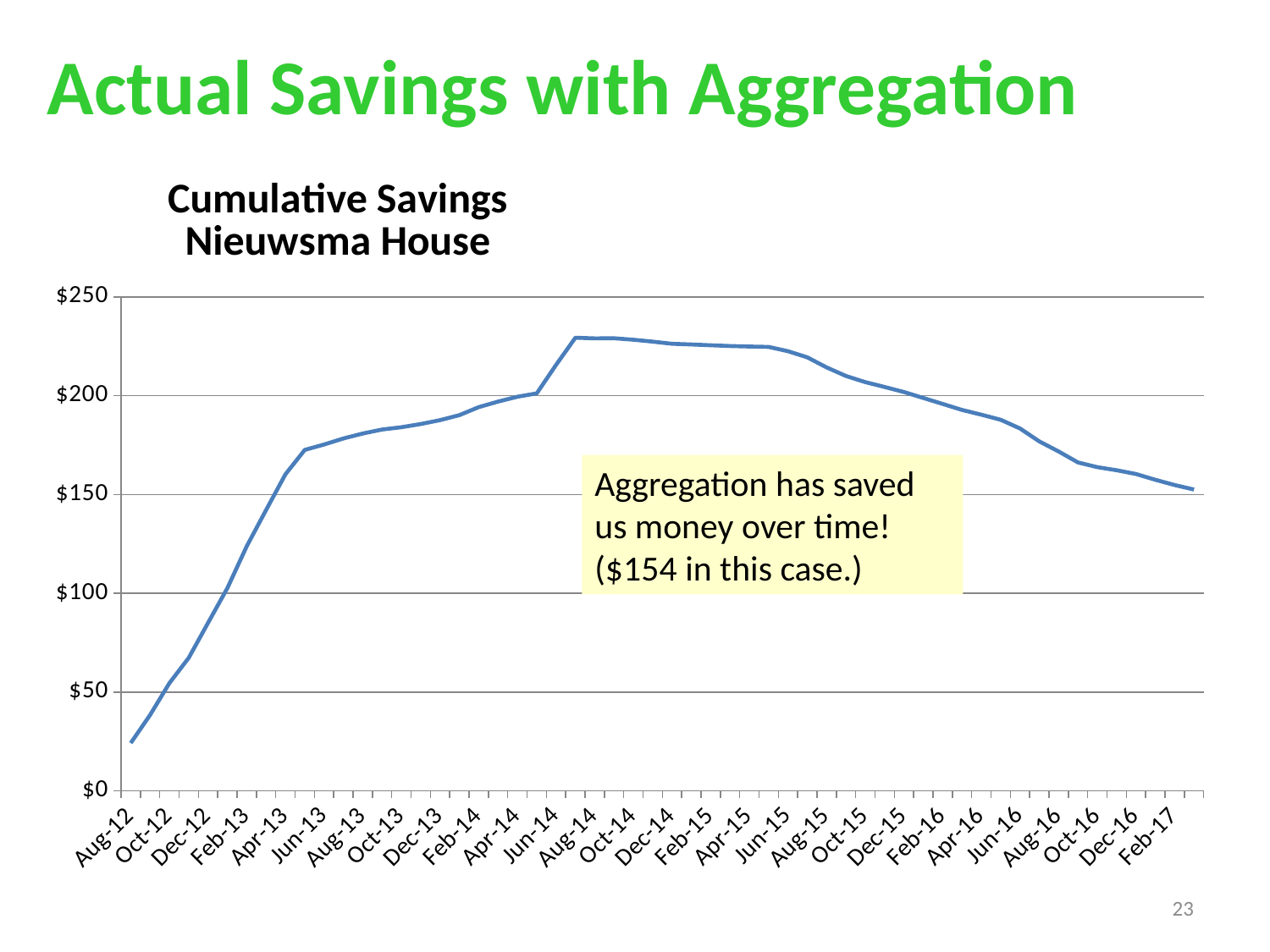
Is the cumulative savings value for Jun-13 greater or less than $150? greater At which labelled month does the cumulative savings line reach its highest point? Aug-14 What kind of chart is shown on the slide? line chart According to the text box on the chart, how much has aggregation saved in this case? $154 At which labelled month is the cumulative savings value lowest? Aug-12 Is the cumulative savings value for Jun-15 greater or less than $200? greater Is the cumulative savings value for Aug-12 greater or less than $50? less What is the title of the chart? Cumulative Savings Nieuwsma House Do the cumulative savings values rise or fall between Aug-14 and Feb-17? fall Which has the larger cumulative savings value, Aug-14 or Feb-17? Aug-14